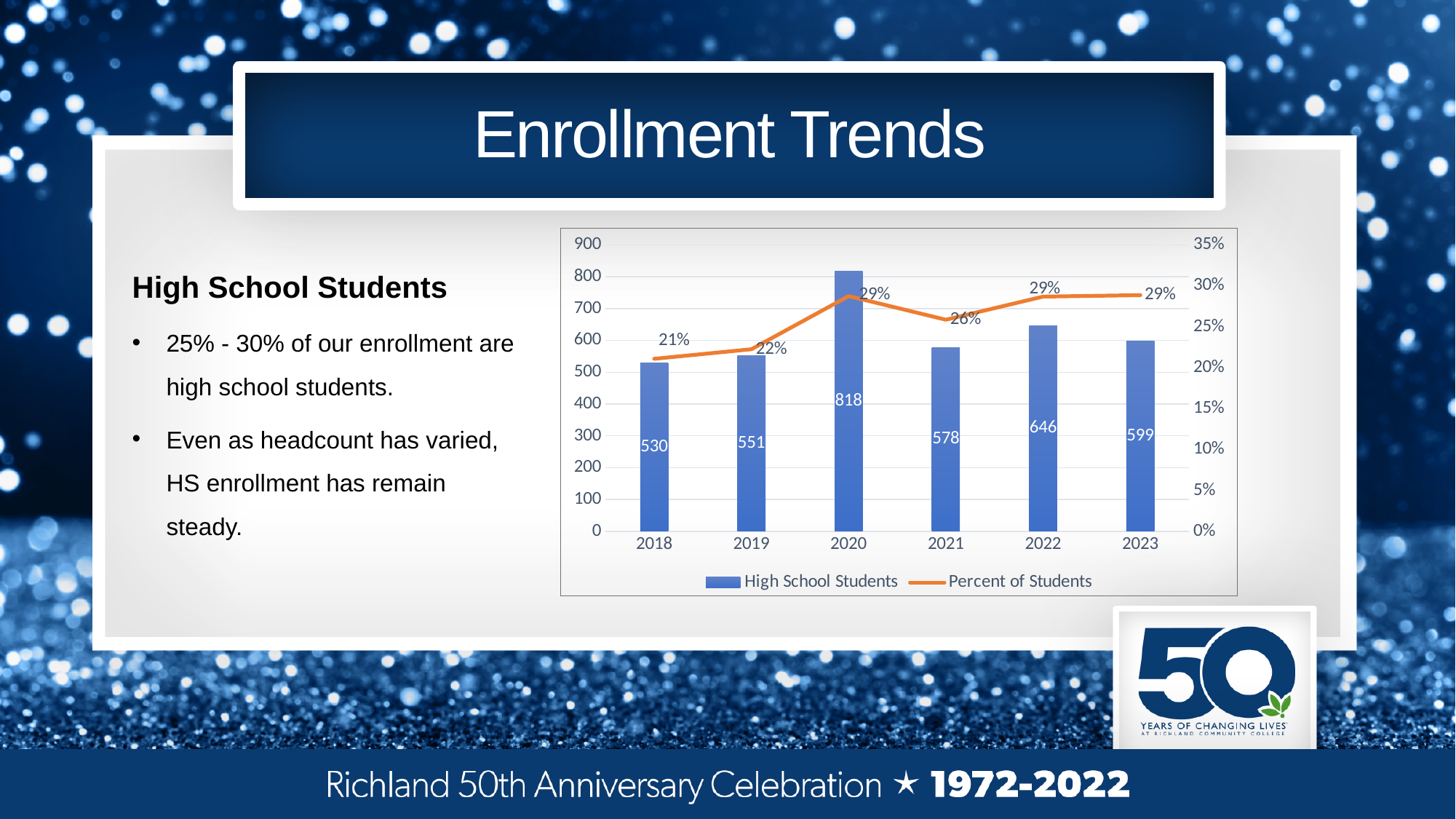
How many series does the legend list? 2 How many years are shown on the x axis? 6 Which year had the highest number of high school students? 2020 Which year had the lowest percent of students? 2018 What kind of chart is used for the High School Students series? Bar chart What is the difference in high school students between 2020 and 2021? 240 How many high school students were enrolled in 2020? 818 What colour is the Percent of Students line? Orange Which year had the lowest number of high school students? 2018 What was the percent of students for 2018? 21% Which year had more high school students, 2022 or 2023? 2022 How many high school students were enrolled in 2022? 646